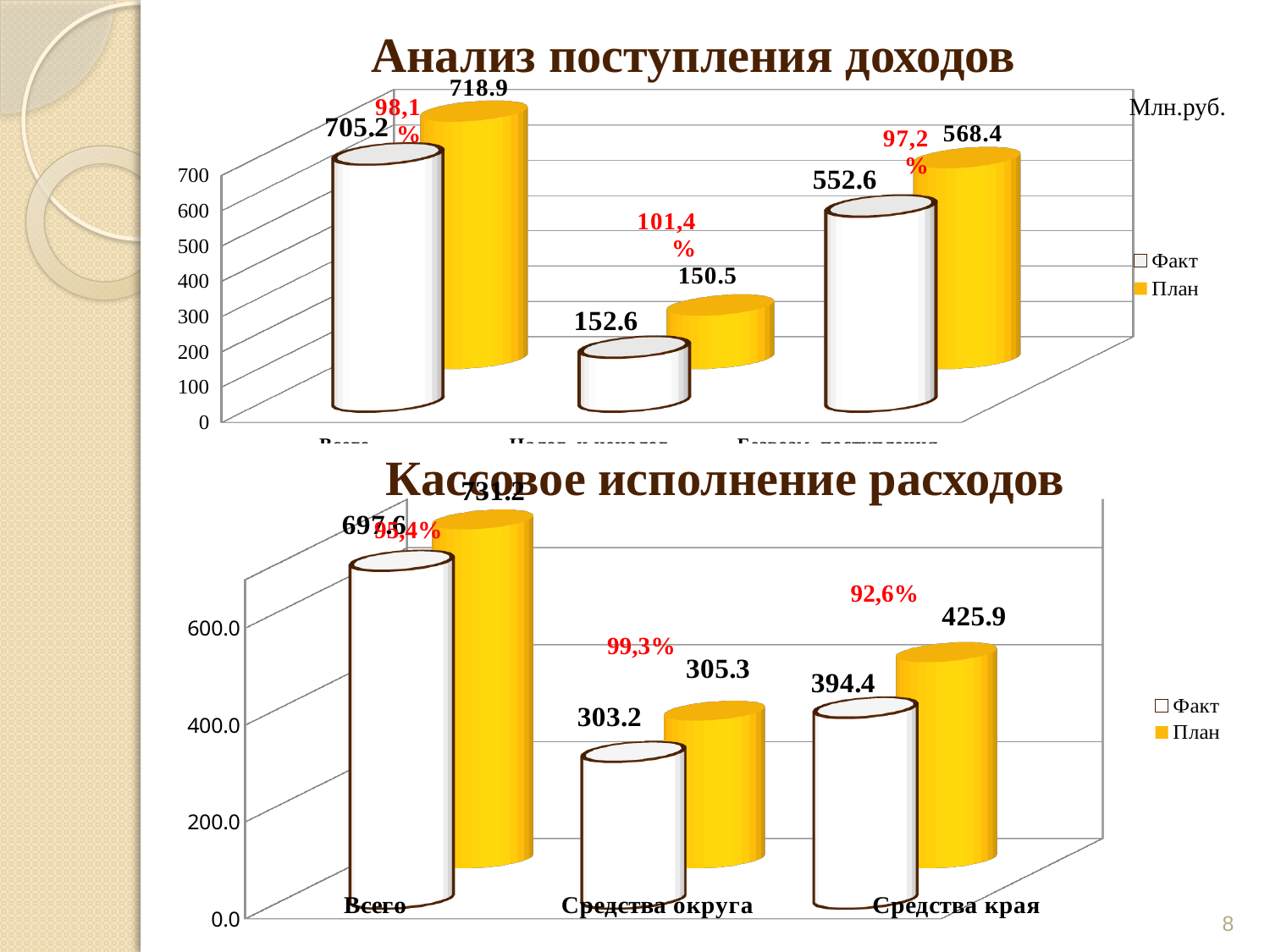
In the chart titled "Анализ поступления доходов", what is the difference between the План and Факт values in the rightmost category group? 15.8 In the chart titled "Анализ поступления доходов", what is the План value for the first (leftmost) category group? 718.9 In the chart titled "Анализ поступления доходов", what is the Факт value for the middle category group? 152.6 In the chart titled "Кассовое исполнение расходов", what is the Факт value for Средства округа? 303.2 How many series does the legend of the chart titled "Анализ поступления доходов" list? 2 What type of chart is the chart titled "Кассовое исполнение расходов"? Bar chart In the chart titled "Кассовое исполнение расходов", what is the План value for Средства края? 425.9 In the chart titled "Анализ поступления доходов", in the middle category group, which is larger, Факт or План? Факт In the chart titled "Кассовое исполнение расходов", what is the difference between the План and Факт values for Средства края? 31.5 In the chart titled "Кассовое исполнение расходов", what is the Факт value for Всего? 697.6 In the chart titled "Кассовое исполнение расходов", which category has the lowest Факт value? Средства округа In the chart titled "Кассовое исполнение расходов", is the Факт value for Средства края greater or less than 400.0? less